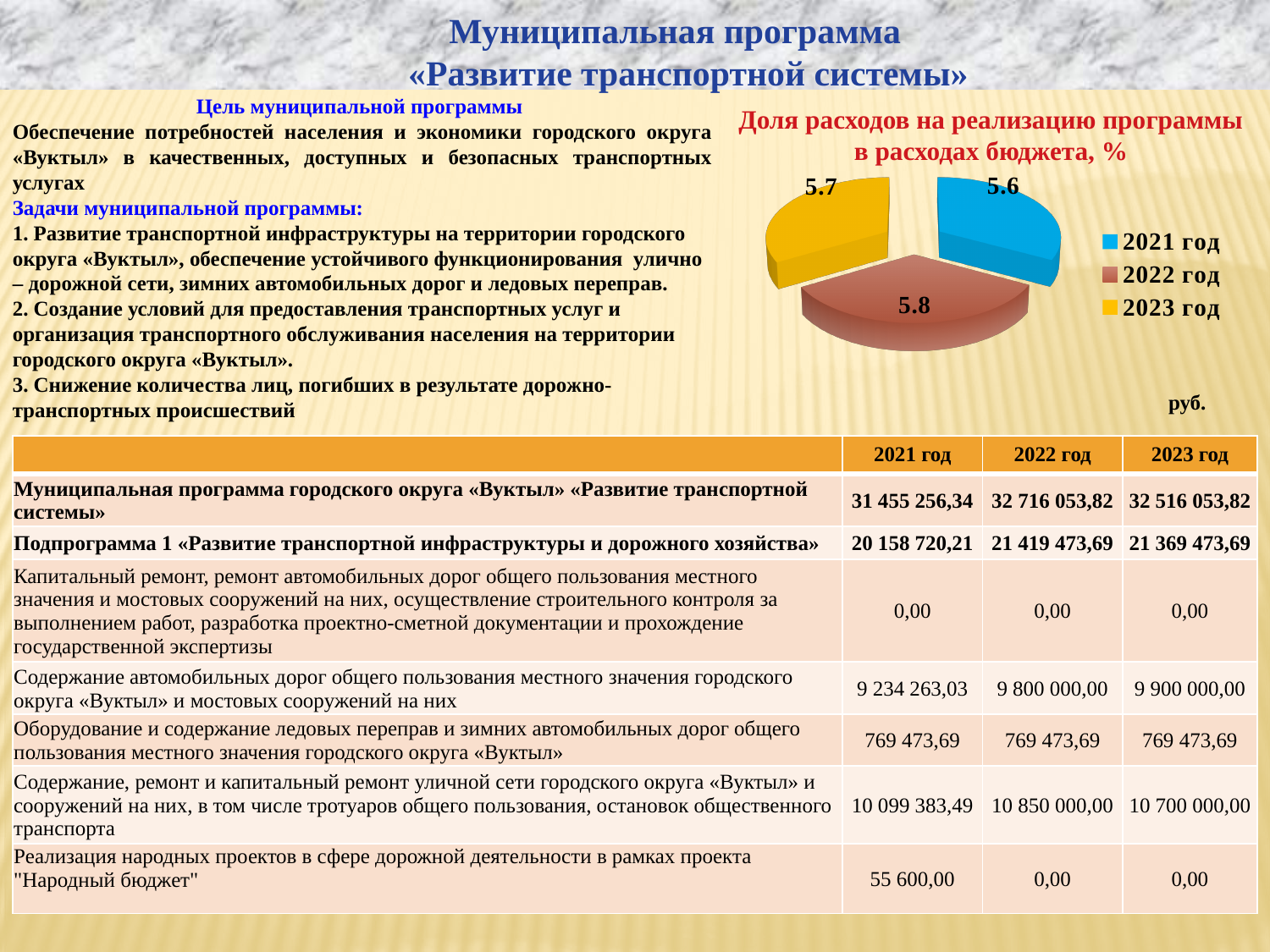
How many entries does the legend of the pie chart list? 3 Which year has the smallest slice in the pie chart? 2021 год What colour is the slice for 2023 год in the pie chart? Yellow How many slices does the pie chart have? 3 What is the difference between the values for 2022 год and 2021 год in the pie chart? 0.2 What is the difference between the values for 2023 год and 2021 год in the pie chart? 0.1 What kind of chart is shown on the slide? Pie chart Which year has the largest slice in the pie chart? 2022 год Which is larger in the pie chart, the value for 2022 год or the value for 2023 год? 2022 год What is the value for 2021 год in the pie chart? 5.6 What is the value for 2022 год in the pie chart? 5.8 What is the value for 2023 год in the pie chart? 5.7